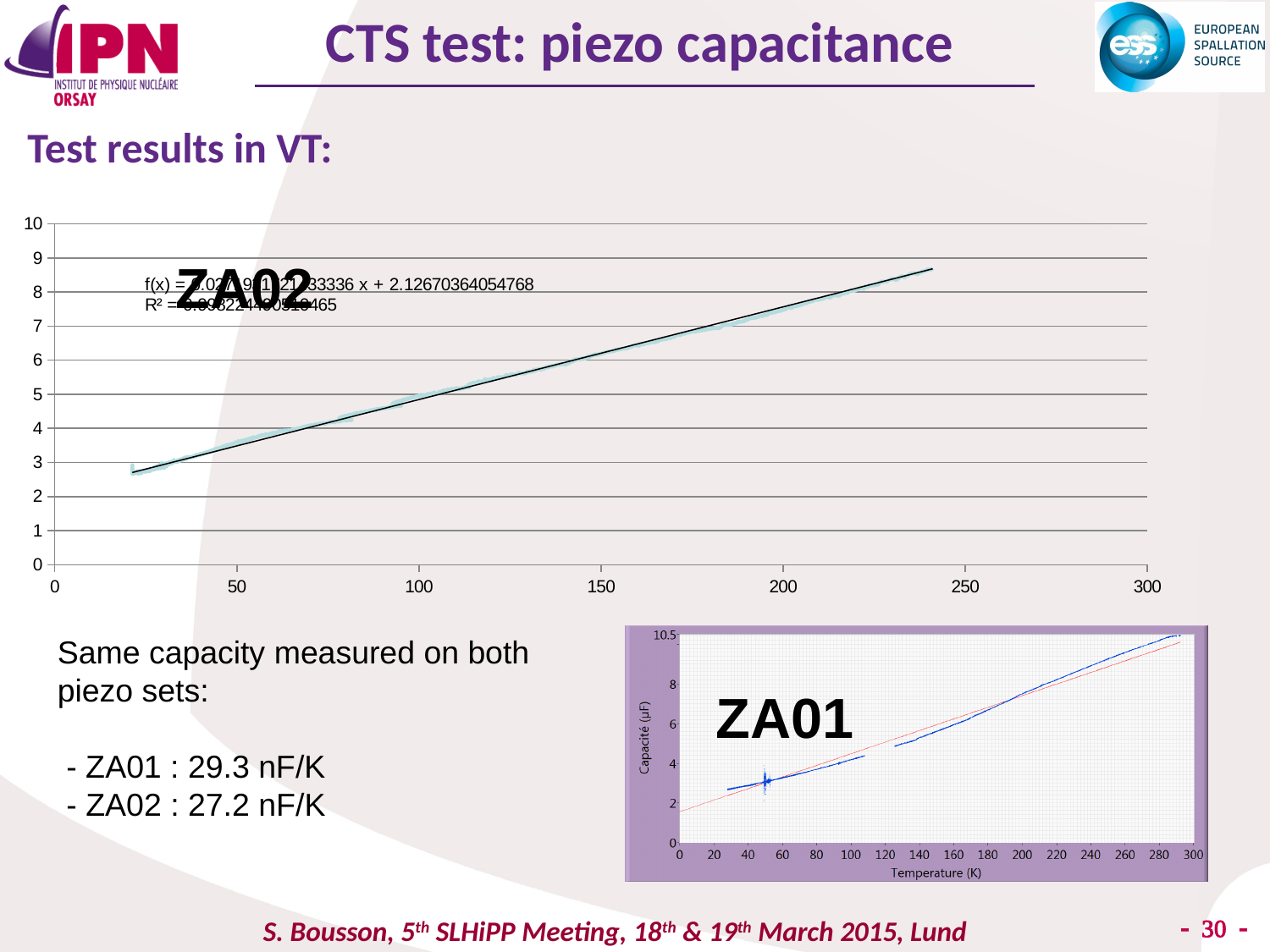
In the bottom-right chart (ZA01), do the plotted values rise or fall as temperature increases? rise What is the highest tick value on the y-axis of the top chart (ZA02)? 10 What is the y-axis label of the bottom-right chart (ZA01)? Capacité (µF) In the bottom-right chart (ZA01), is the value at 100 K greater or less than 6? less In the top chart (ZA02), is the value at x = 240 greater or less than 8? greater In the top chart (ZA02), is the value at x = 200 greater or less than 8? less What kind of chart is the large top chart labelled ZA02? scatter chart with a linear trendline What is the intercept (constant term) of the trendline equation shown on the top chart (ZA02)? 2.12670364054768 In the top chart (ZA02), do the plotted values rise or fall as the x-axis value increases from 0 to 250? rise